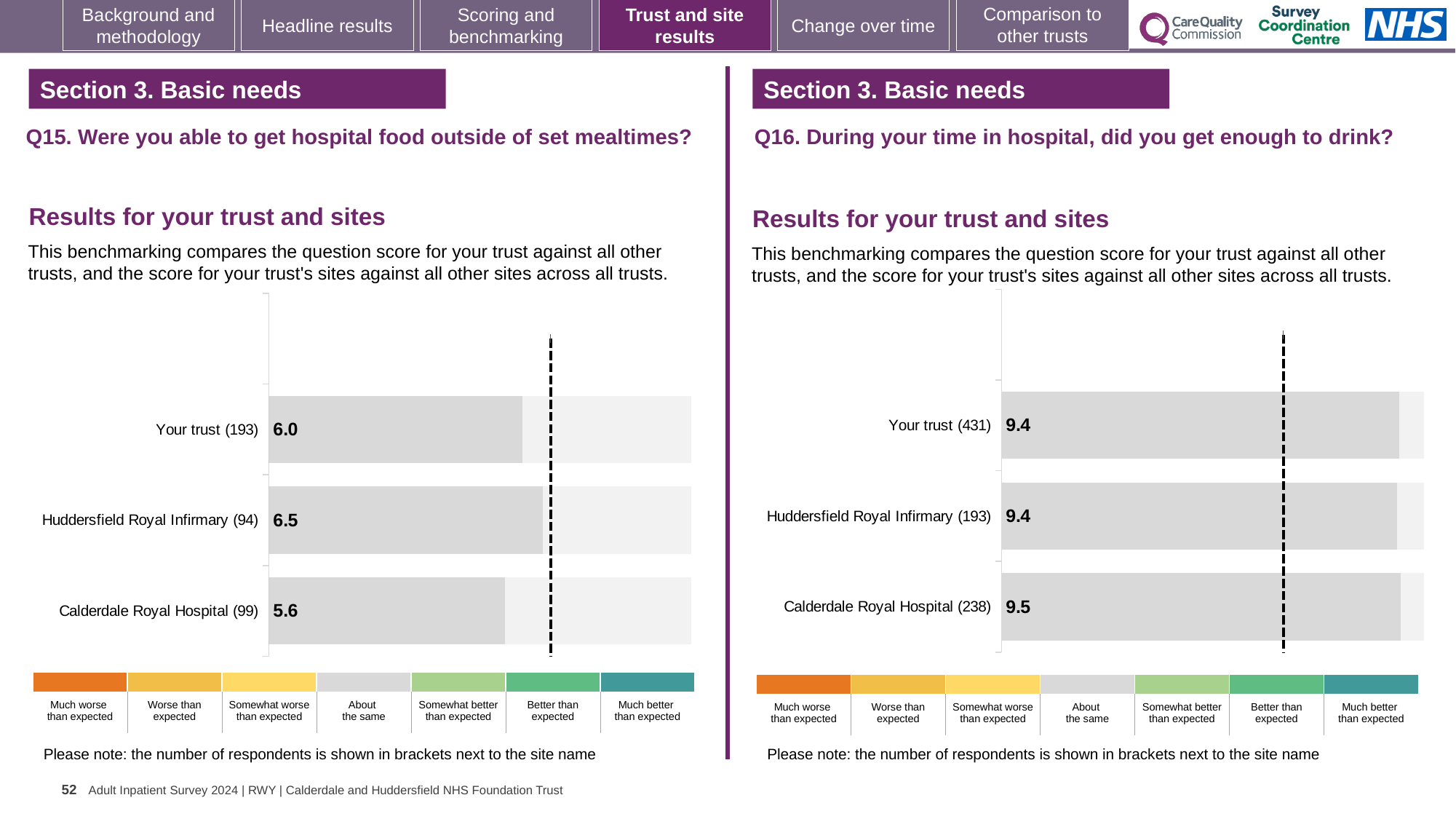
What type of chart is used in the Q15 chart (left)? Bar chart In the Q15 chart (left), what is the score for Calderdale Royal Hospital? 5.6 In the Q15 chart (left), what is the score for Your trust? 6.0 In the Q16 chart (right), how many respondents are shown in brackets for Huddersfield Royal Infirmary? 193 In the Q15 chart (left), which site or trust has the highest score? Huddersfield Royal Infirmary In the Q15 chart (left), what is the score for Huddersfield Royal Infirmary? 6.5 In the Q15 chart (left), what is the difference between the scores for Huddersfield Royal Infirmary and Calderdale Royal Hospital? 0.9 In the Q16 chart (right), what is the score for Calderdale Royal Hospital? 9.5 In the Q16 chart (right), how many bars are plotted? 3 In the Q16 chart (right), what is the score for Your trust? 9.4 In the Q16 chart (right), which site or trust has the highest score? Calderdale Royal Hospital In the Q15 chart (left), which site or trust has the lowest score? Calderdale Royal Hospital